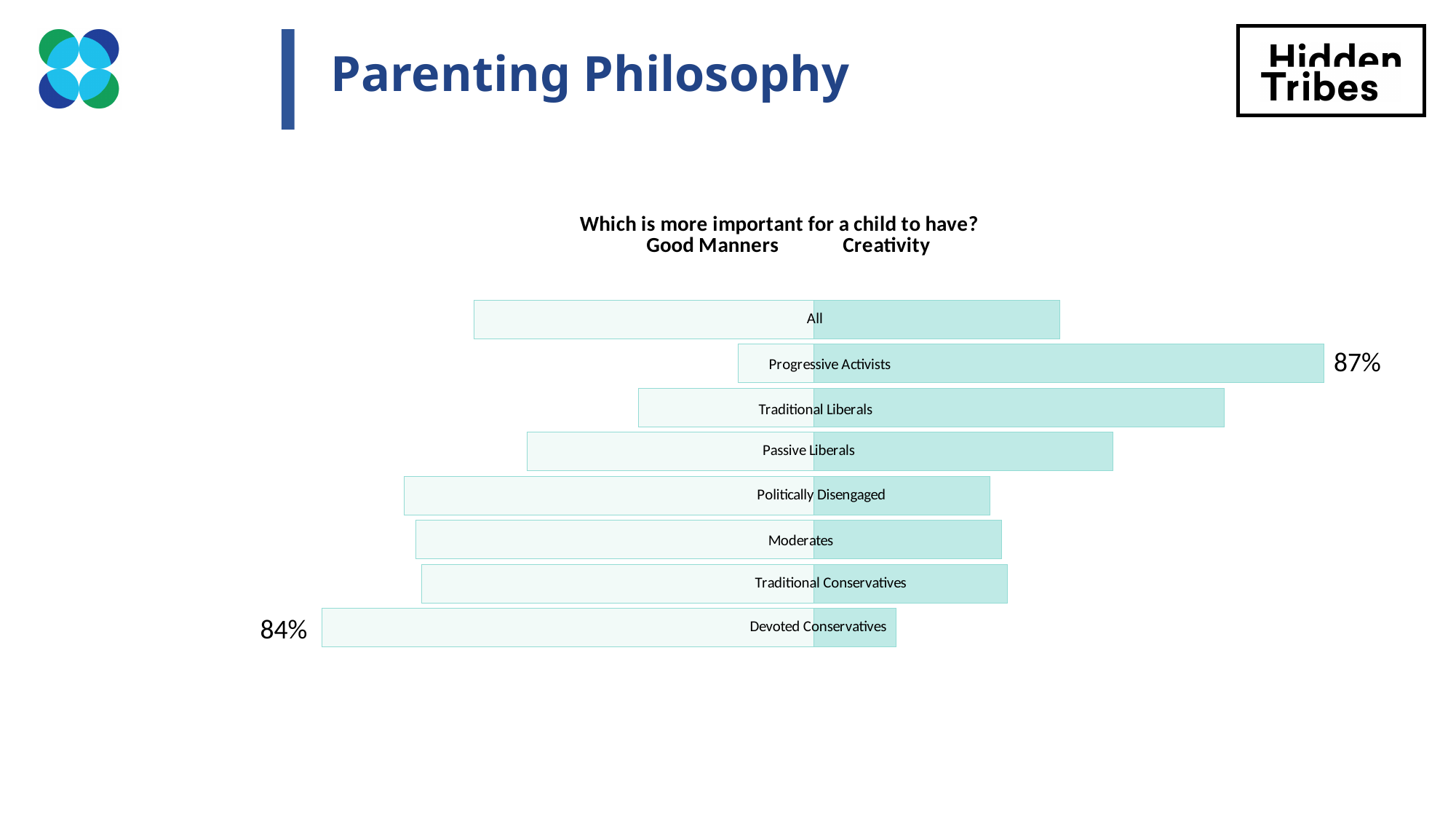
Which is larger: the Creativity value for Progressive Activists or the Creativity value for Traditional Liberals? Progressive Activists What percentage of Progressive Activists say Creativity is more important for a child to have? 87% Which group has the highest value for Creativity? Progressive Activists How many response options (series) does the chart show? 2 Which group has the lowest value for Good Manners? Progressive Activists Which group has the highest value for Good Manners? Devoted Conservatives For Politically Disengaged, which is larger: the Good Manners value or the Creativity value? Good Manners What percentage of Devoted Conservatives say Good Manners is more important for a child to have? 84% How many groups are shown in the chart? 8 For the All group, which is larger: the Good Manners value or the Creativity value? Good Manners What kind of chart is shown on the slide? Bar chart Which group has the lowest value for Creativity? Devoted Conservatives